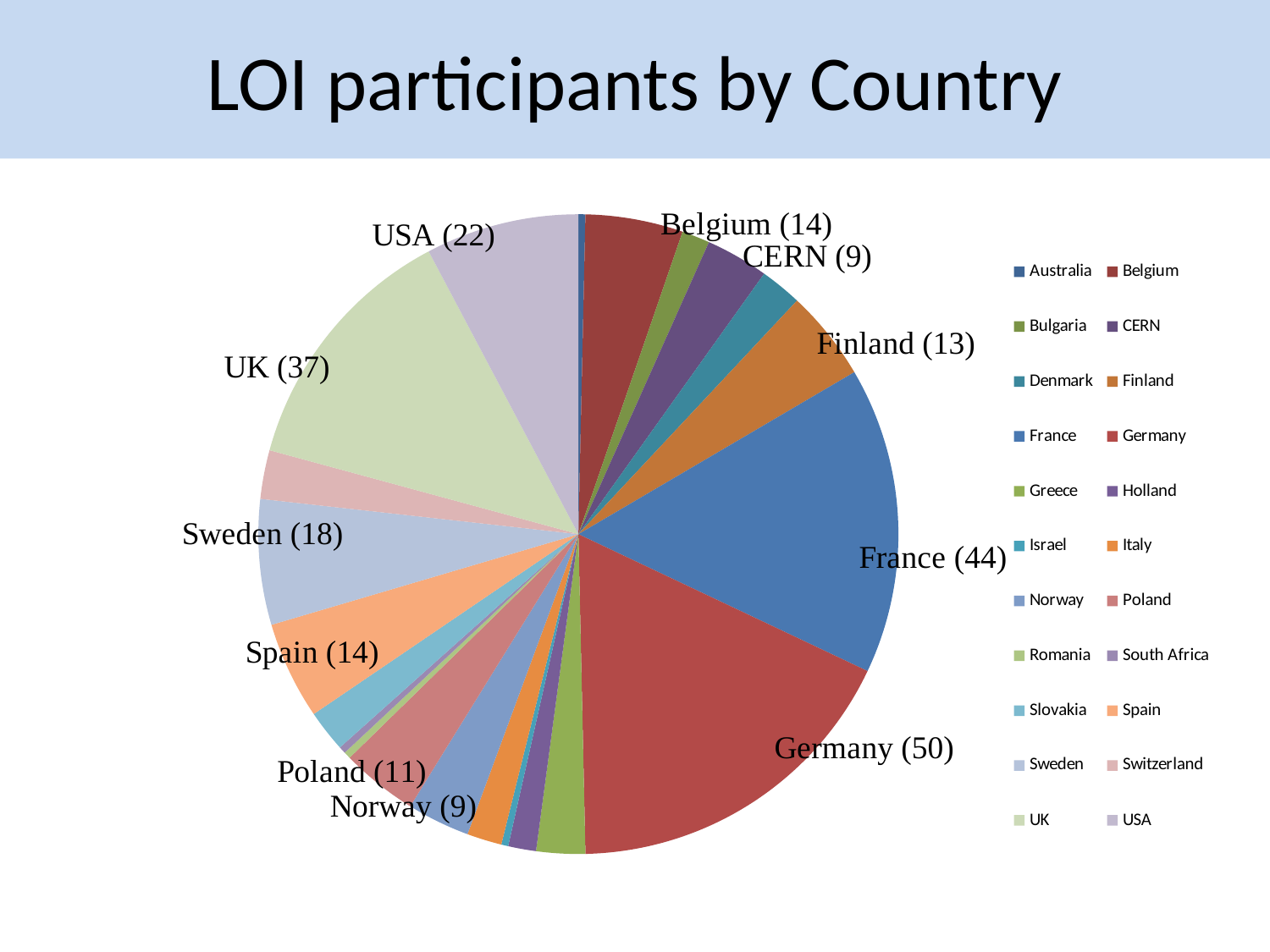
How many LOI participants are from Germany? 50 Which country has the largest slice of the pie? Germany How many countries are listed in the legend? 22 How many LOI participants are from the UK? 37 How many LOI participants are from Finland? 13 What is the title of the chart? LOI participants by Country What is the difference between the number of participants from the UK and from the USA? 15 How many LOI participants are from France? 44 Which has more participants, Spain or Poland? Spain What is the difference between the number of participants from Germany and from France? 6 What kind of chart is shown on the slide? pie chart How many LOI participants are from Sweden? 18